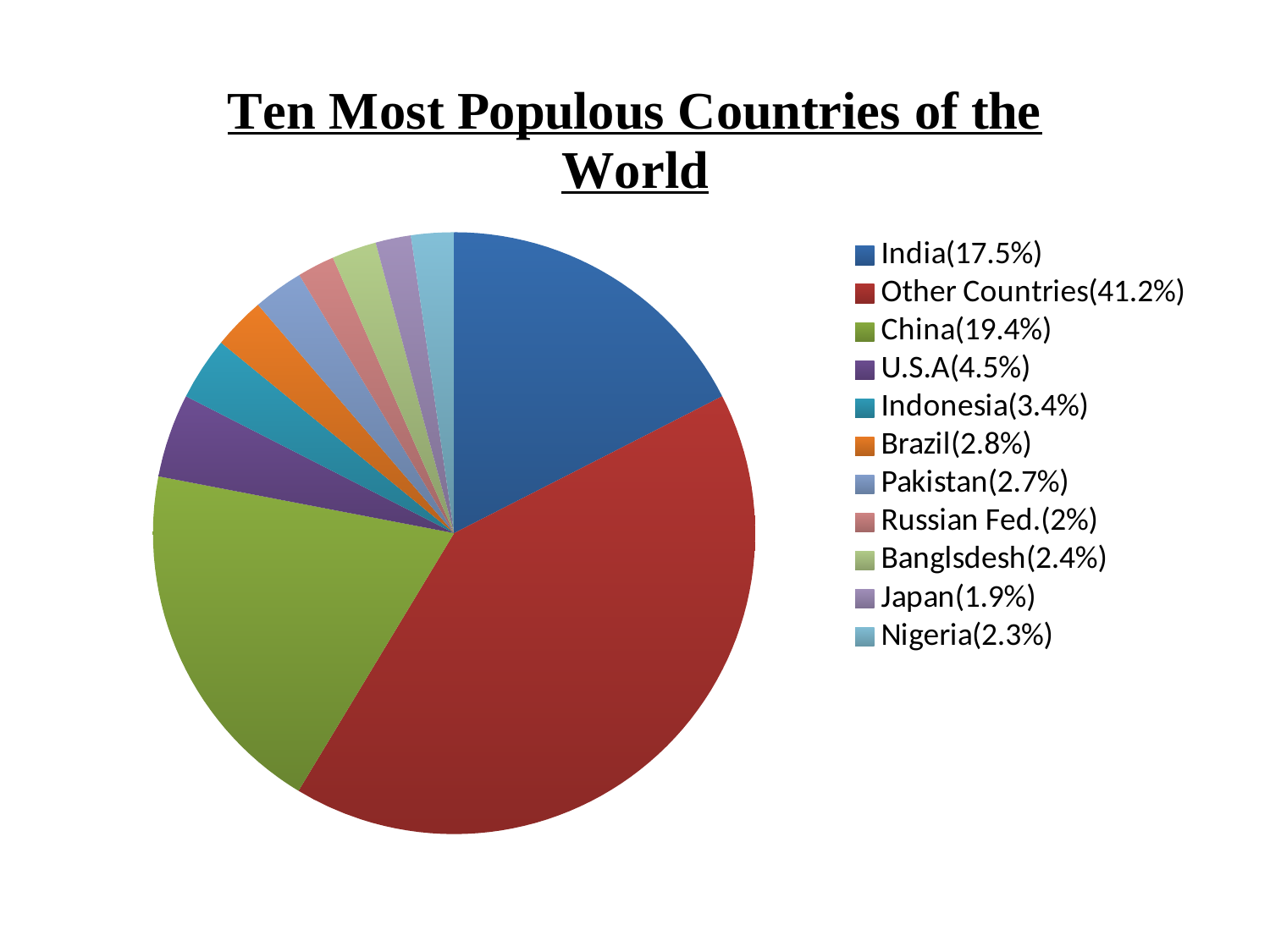
What percentage share is shown for Indonesia? 3.4% Which has the larger share, U.S.A or Indonesia? U.S.A What kind of chart is shown on the slide? pie chart What percentage share is shown for China? 19.4% Which country has the smallest share of the pie? Japan Which has the larger share, China or India? China What is the title of the slide? Ten Most Populous Countries of the World What is the difference between China's share and India's share? 1.9% How many slices does the pie chart have? 11 What share of the pie does Other Countries represent? 41.2% What percentage share does India have according to the legend? 17.5% Which legend entry has the largest share of the pie? Other Countries